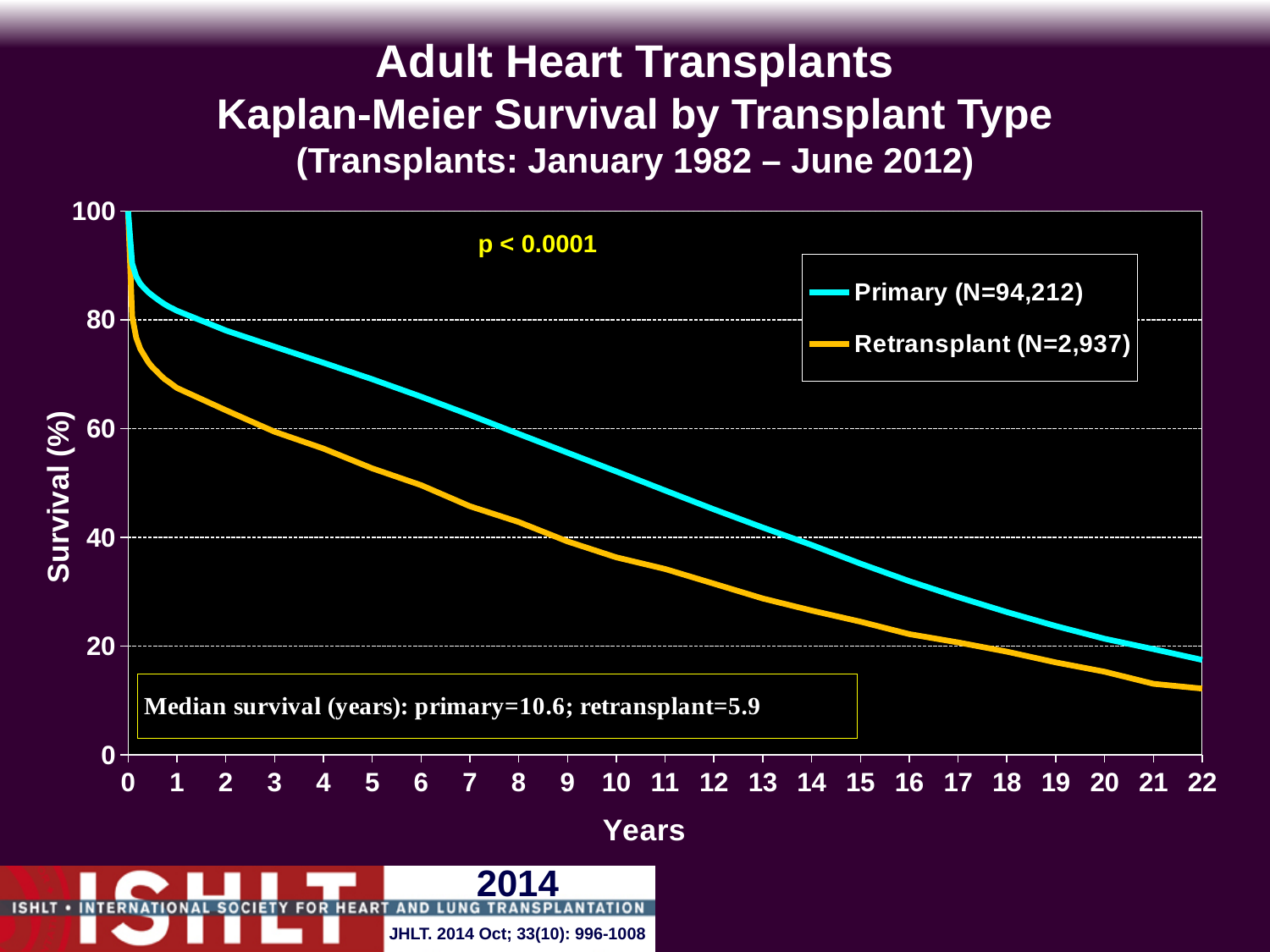
What kind of chart is shown on the slide? Line chart What is the sample size (N) for the Retransplant series shown in the legend? 2,937 How many series does the legend list? 2 What is the median survival in years for retransplants? 5.9 What is the difference in median survival (years) between primary transplants and retransplants? 4.7 Which series has higher survival at 10 years, Primary or Retransplant? Primary Is the survival for the Primary series at 10 years greater or less than 60? less Is the survival for the Retransplant series at 22 years greater or less than 20? less What is the sample size (N) for the Primary series shown in the legend? 94,212 What is the median survival in years for primary transplants? 10.6 Is the survival for the Retransplant series at 5 years greater or less than 40? greater Do the survival curves rise or fall as years increase? Fall